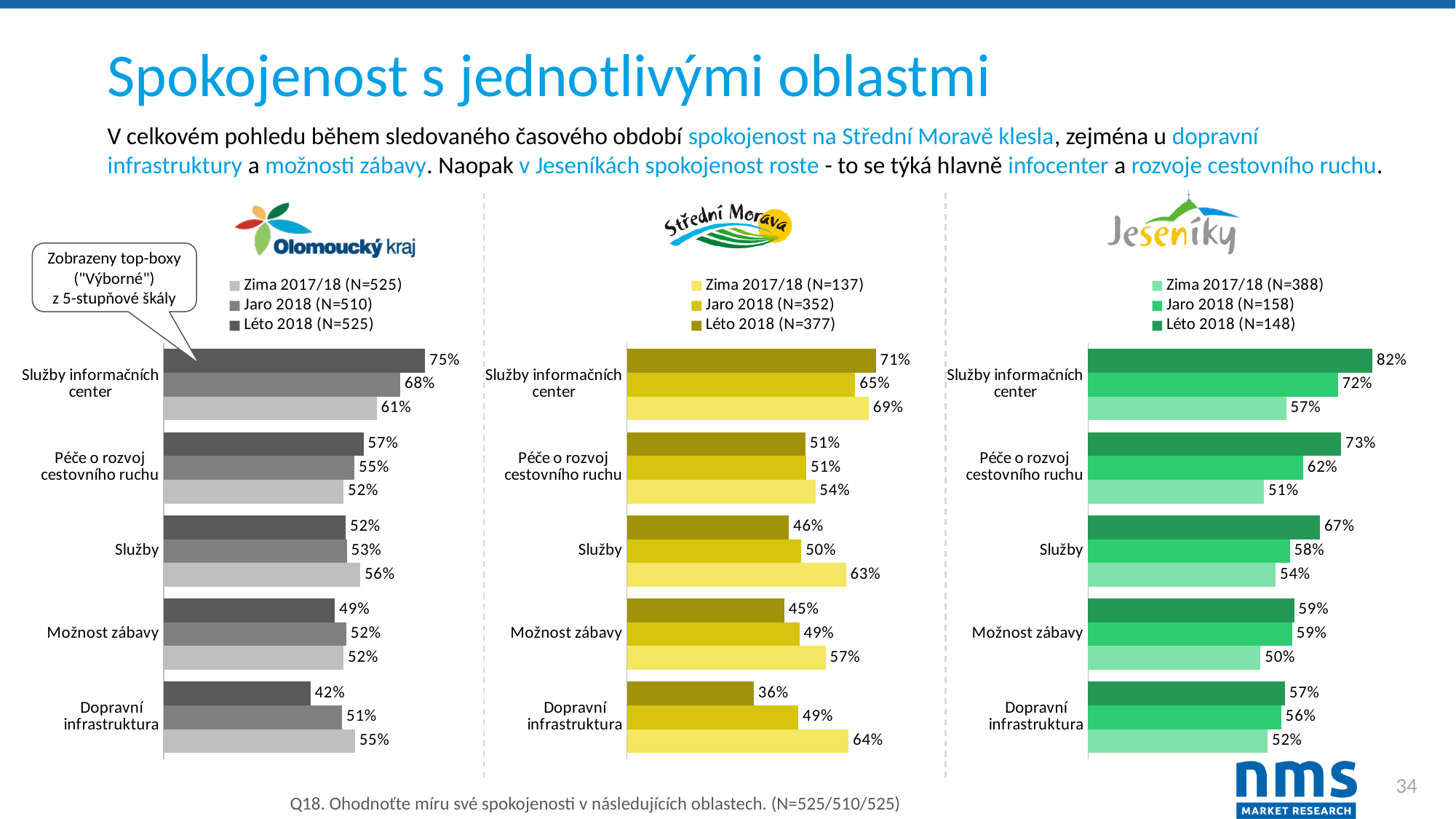
In the Jeseníky chart, what is the Zima 2017/18 value for Péče o rozvoj cestovního ruchu? 51% In the Jeseníky chart, which category has the highest Léto 2018 value? Služby informačních center In the Střední Morava chart, which category has the lowest Léto 2018 value? Dopravní infrastruktura In the Jeseníky chart, what is the difference between the Léto 2018 and Zima 2017/18 values for Služby informačních center? 25 percentage points In the Střední Morava chart, which is larger for Služby: the Zima 2017/18 value or the Léto 2018 value? Zima 2017/18 How many categories are shown in the Olomoucký kraj chart? 5 In the Olomoucký kraj chart, what is the difference between the Léto 2018 and Zima 2017/18 values for Služby informačních center? 14 percentage points What type of chart is used for the Jeseníky data? Bar chart In the Střední Morava chart, what sample size (N) is given for Jaro 2018 in the legend? N=352 How many series does the legend of the Střední Morava chart list? 3 In the Olomoucký kraj chart, what is the Léto 2018 value for Služby informačních center? 75% In the Střední Morava chart, what is the Léto 2018 value for Dopravní infrastruktura? 36%